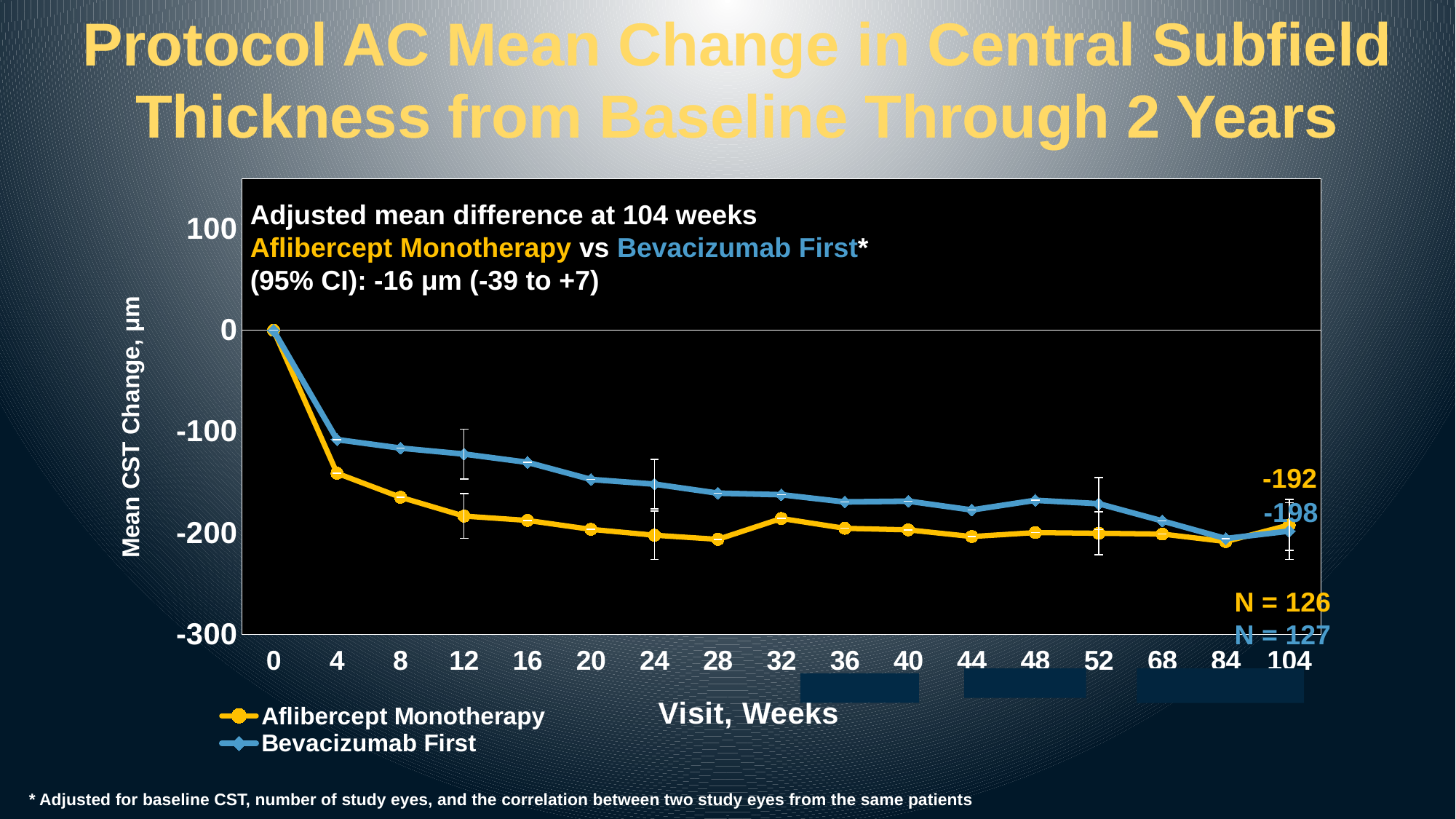
At week 104, which series has the lower mean CST change? Bevacizumab First What is the value for Aflibercept Monotherapy at week 104? -192 At week 24, which series has the higher mean CST change? Bevacizumab First Do the values for Aflibercept Monotherapy rise or fall from week 0 to week 4? fall Is the value for Aflibercept Monotherapy at week 4 greater or less than -100? less Is the value for Bevacizumab First at week 52 greater or less than -200? greater What is the N shown for Aflibercept Monotherapy? N = 126 How many series does the legend list? 2 What is the value for Bevacizumab First at week 104? -198 What is the difference between the Aflibercept Monotherapy and Bevacizumab First values at week 104? 6 How many visit time points are shown on the x axis? 17 What kind of chart is shown on the slide? line chart